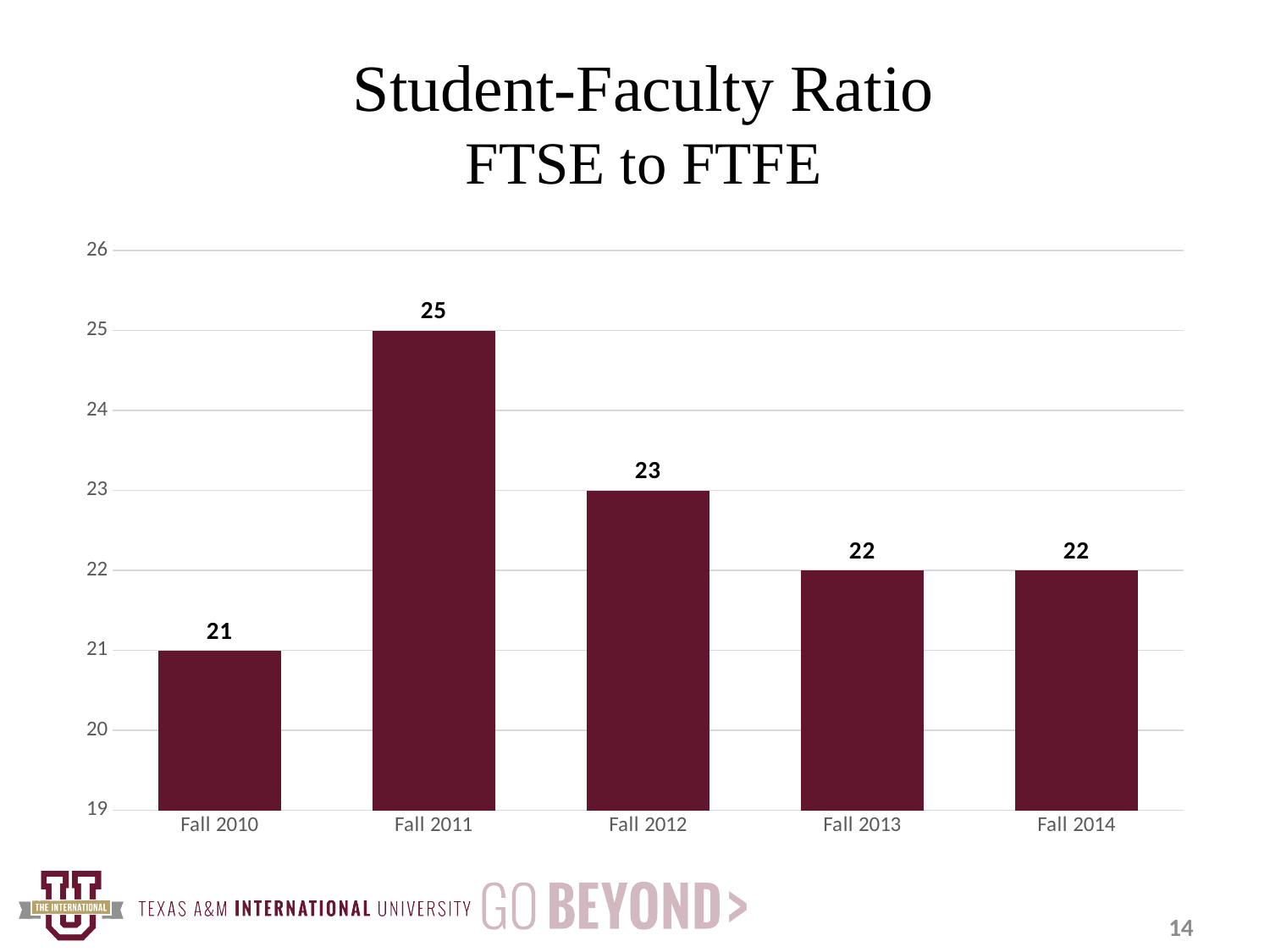
What is the difference between the ratio for Fall 2011 and the ratio for Fall 2010? 4 What is the title of the chart? Student-Faculty Ratio FTSE to FTFE What kind of chart is shown on the slide? Bar chart What is the student-faculty ratio for Fall 2014? 22 What is the student-faculty ratio for Fall 2010? 21 Which term has the lowest student-faculty ratio? Fall 2010 How many terms are shown on the chart? 5 What is the difference between the ratio for Fall 2012 and the ratio for Fall 2013? 1 Which is larger, the ratio for Fall 2012 or the ratio for Fall 2014? Fall 2012 What is the student-faculty ratio for Fall 2011? 25 Does the student-faculty ratio rise or fall from Fall 2011 to Fall 2013? Fall Which term has the highest student-faculty ratio? Fall 2011